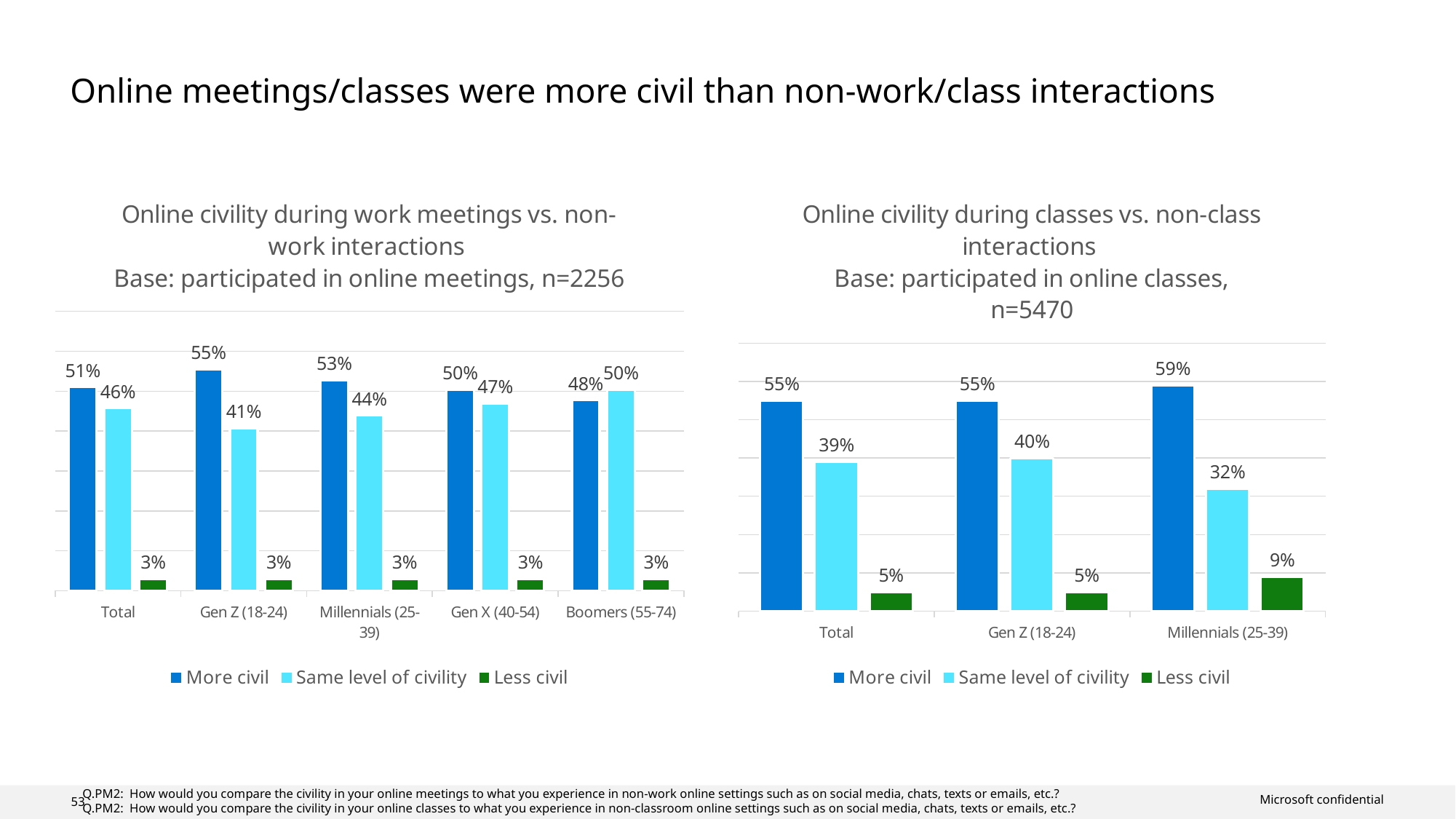
How many categories are shown on the x axis of the right chart (classes vs. non-class interactions)? 3 In the right chart (classes vs. non-class interactions), which category has the lowest 'Same level of civility' value? Millennials (25-39) In the right chart (classes vs. non-class interactions), what is the 'Same level of civility' value for Total? 39% In the left chart (work meetings vs. non-work interactions), which is larger for Boomers (55-74): 'More civil' or 'Same level of civility'? Same level of civility How many series does the legend of the right chart (classes vs. non-class interactions) list? 3 In the right chart (classes vs. non-class interactions), what is the 'Less civil' value for Millennials (25-39)? 9% In the right chart (classes vs. non-class interactions), what is the difference between the 'More civil' and 'Same level of civility' values for Millennials (25-39)? 27% In the left chart (work meetings vs. non-work interactions), what is the 'More civil' value for Gen Z (18-24)? 55% What kind of chart is the left chart (work meetings vs. non-work interactions)? Bar chart In the left chart (work meetings vs. non-work interactions), which category has the highest 'More civil' value? Gen Z (18-24) How many categories are shown on the x axis of the left chart (work meetings vs. non-work interactions)? 5 In the left chart (work meetings vs. non-work interactions), what is the 'Same level of civility' value for Boomers (55-74)? 50%